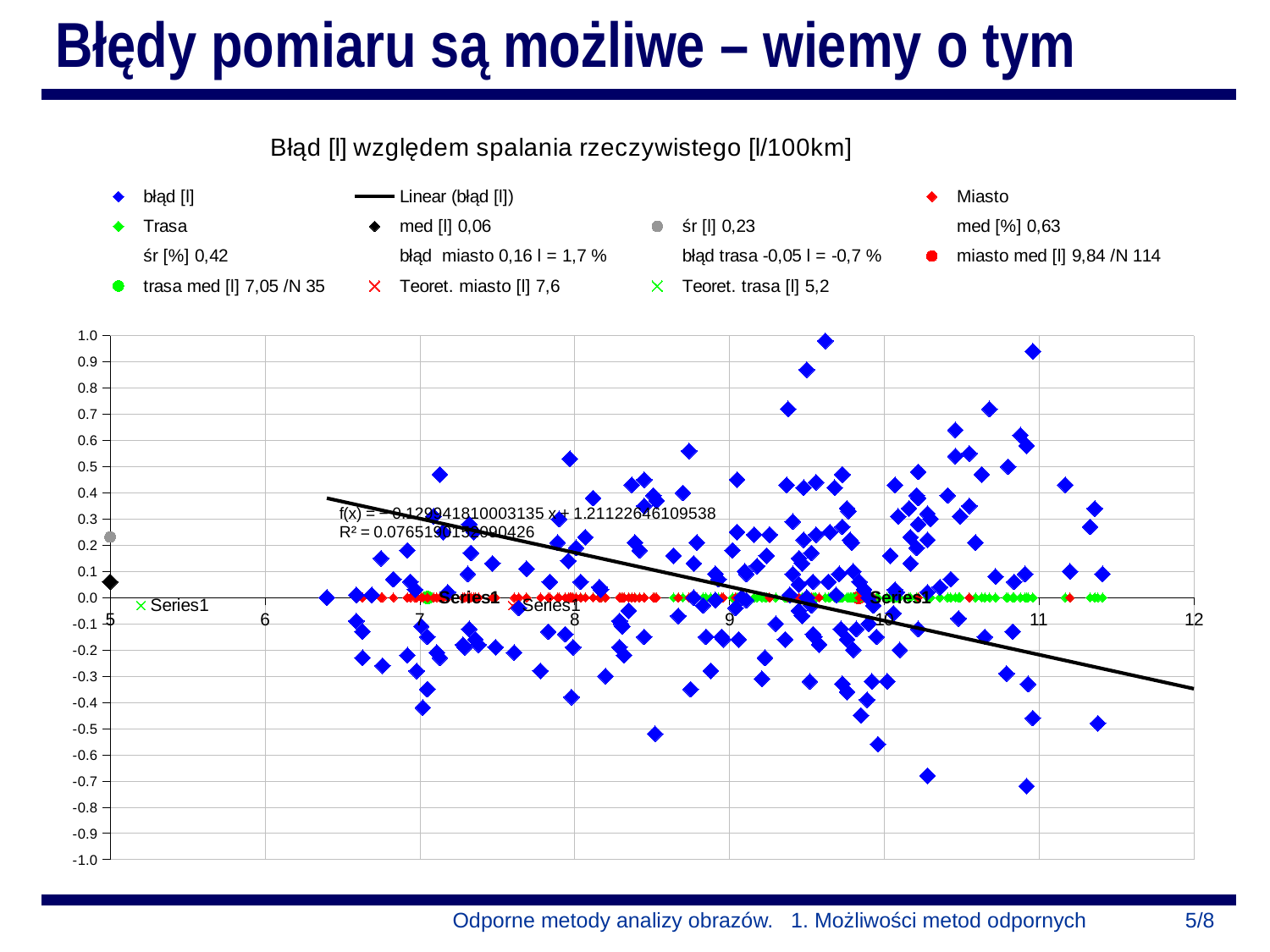
Is the value of the trendline at x = 12 greater or less than 0.0? less Is the highest blue 'błąd [l]' point on the chart greater or less than 0.9? greater Which is larger, the 'miasto med [l]' value or the 'trasa med [l]' value? miasto med [l] What kind of chart is shown on the slide? scatter chart What value is given for 'śr [l]' in the legend? 0,23 What is the 'miasto med [l]' value shown in the legend? 9,84 Does the fitted linear trendline rise or fall as the x value increases? fall What is the difference between 'Teoret. miasto [l]' (7,6) and 'Teoret. trasa [l]' (5,2)? 2,4 What colour are the 'Miasto' markers in the chart? red What value is given for 'med [l]' in the legend? 0,06 What is the title of the chart? Błąd [l] względem spalania rzeczywistego [l/100km] What is the 'trasa med [l]' value shown in the legend? 7,05